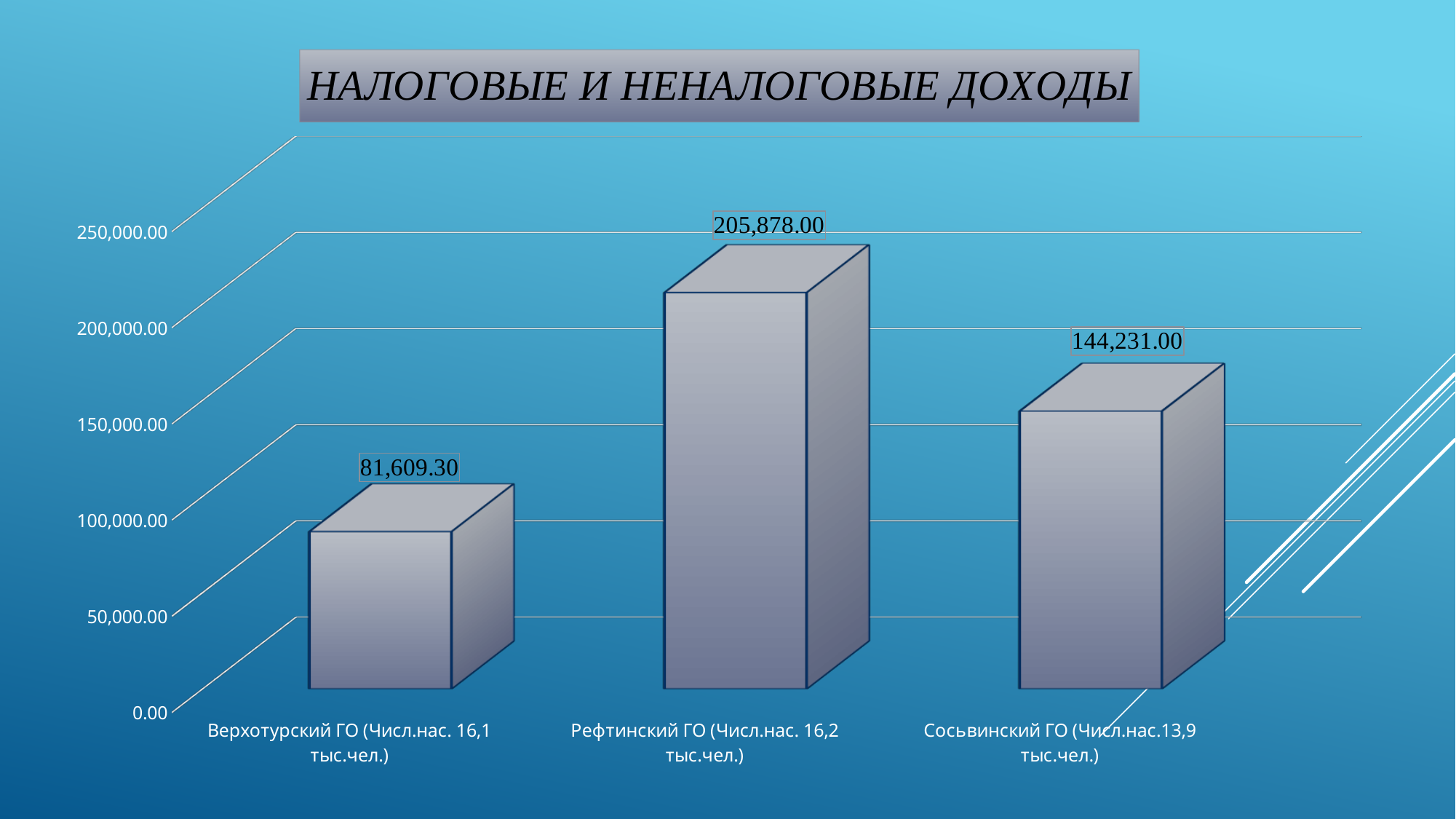
What is the difference between the values for Рефтинский ГО and Верхотурский ГО? 124,268.70 What is the difference between the values for Рефтинский ГО and Сосьвинский ГО? 61,647.00 What is the value for Сосьвинский ГО? 144,231.00 How many categories are shown in the chart? 3 What is the value for Верхотурский ГО? 81,609.30 Which is larger, the value for Сосьвинский ГО or the value for Верхотурский ГО? Сосьвинский ГО Which category has the highest value? Рефтинский ГО What kind of chart is shown on the slide? bar chart Which category has the lowest value? Верхотурский ГО What is the value for Рефтинский ГО? 205,878.00 Is the value for Рефтинский ГО greater or less than 200,000.00? greater What is the title of the chart? НАЛОГОВЫЕ И НЕНАЛОГОВЫЕ ДОХОДЫ